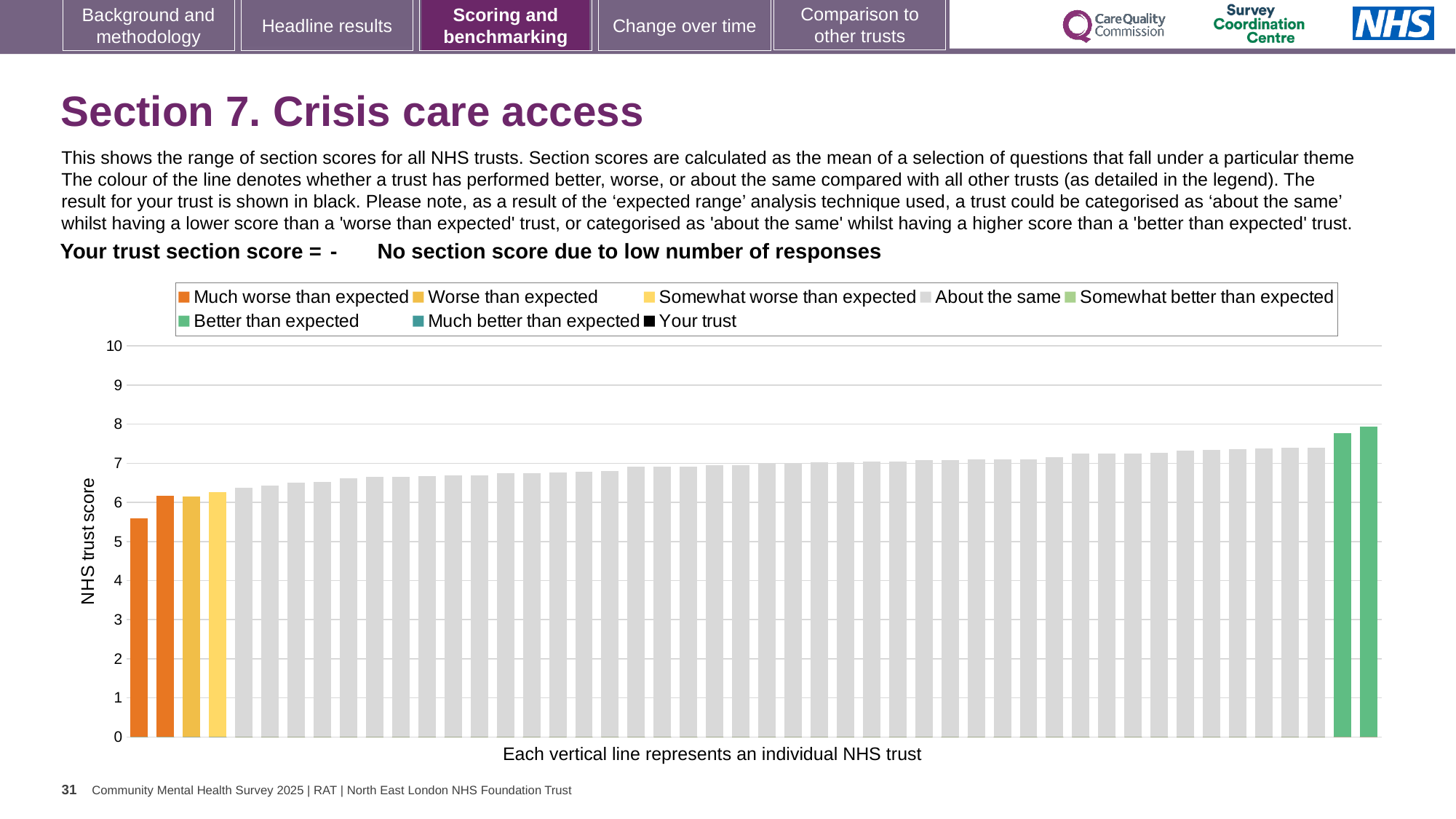
Do the bar values rise or fall from left to right along the x axis? rise What is the highest value shown on the y axis? 10 Which bar is the tallest: the leftmost bar or the rightmost bar? the rightmost bar Is the value of the rightmost (last) bar greater or less than 7? greater How many entries does the chart legend list? 8 How many bars are coloured orange (much worse than expected)? 2 Is the value of the leftmost (first) bar greater or less than 5? greater What is the title of the y axis? NHS trust score What kind of chart is shown on the slide? bar chart Is the value of the leftmost (first) bar greater or less than 6? less What colour are the two tallest bars in the chart? green